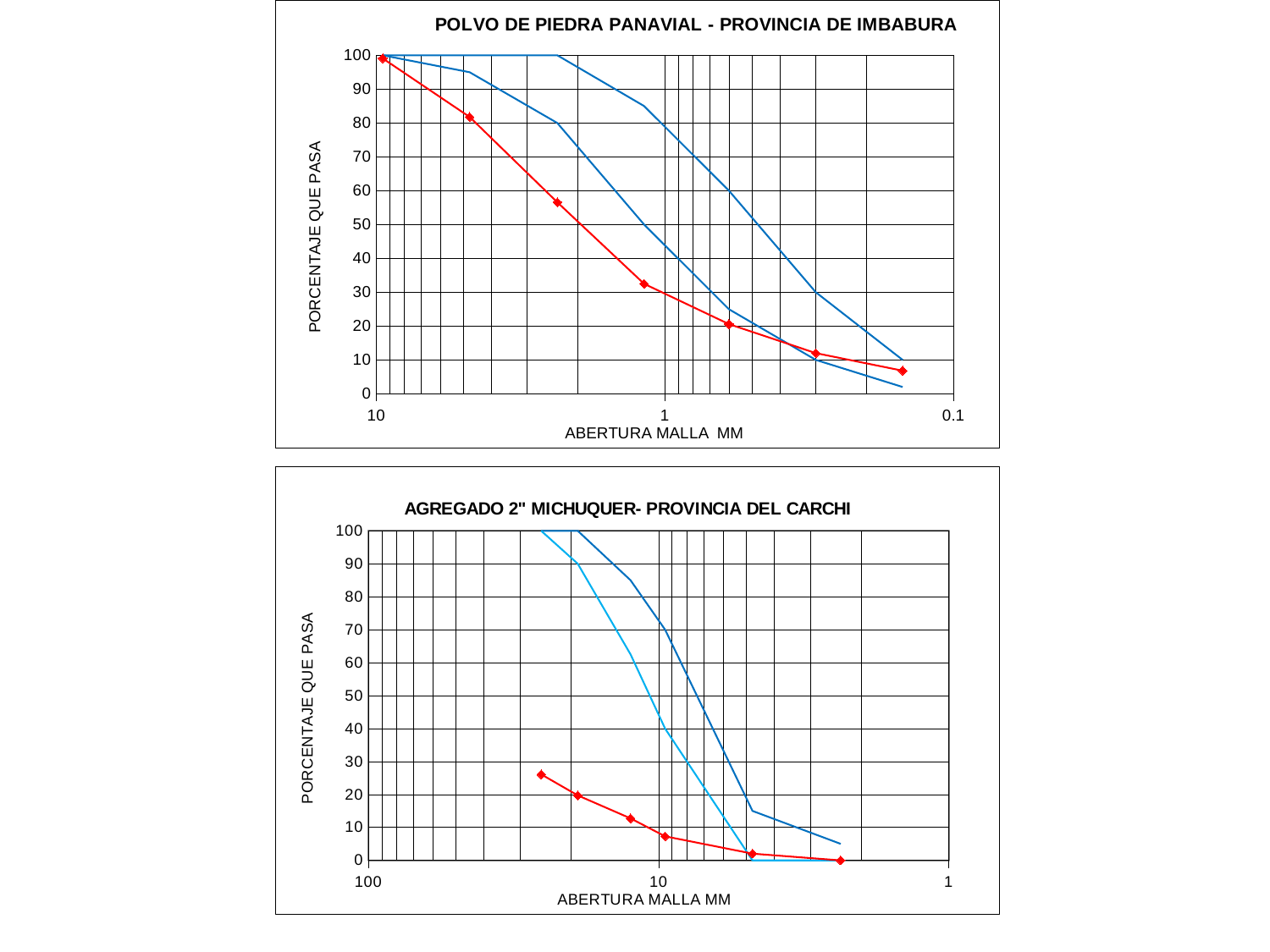
In the bottom chart, is the first (leftmost) value of the red line greater or less than 30? less What is the title of the y axis in the bottom chart? PORCENTAJE QUE PASA In the top chart, how many lines are plotted? 3 In the top chart, do the values of the red line rise or fall from left to right along the x axis? Fall What is the title of the x axis in the top chart? ABERTURA MALLA MM In the bottom chart, how many data-point markers are on the red line? 6 In the bottom chart, is the value of the red line at mesh opening 10 mm greater or less than 10? less What kind of chart is the bottom chart titled 'AGREGADO 2" MICHUQUER- PROVINCIA DEL CARCHI'? Line chart What kind of chart is the top chart titled 'POLVO DE PIEDRA PANAVIAL - PROVINCIA DE IMBABURA'? Line chart In the top chart, is the value of the red line at mesh opening 10 mm greater or less than 90? greater How many charts are shown on the slide? 2